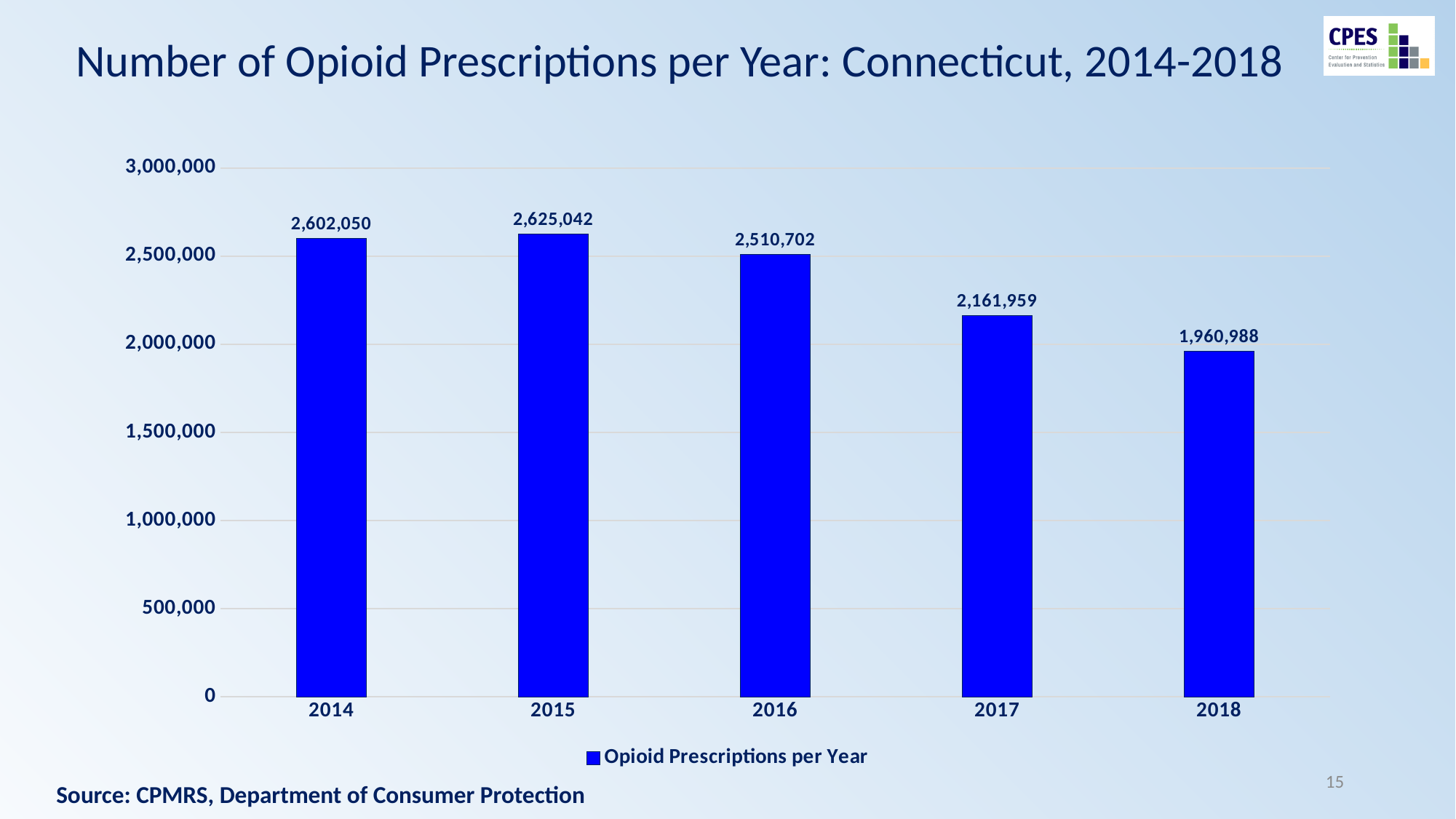
What is the number of opioid prescriptions in 2016? 2,510,702 Which year has the lowest number of opioid prescriptions? 2018 What is the number of opioid prescriptions in 2014? 2,602,050 Do the values rise or fall from 2015 to 2018? Fall How many years are shown on the x axis? 5 What is the difference in opioid prescriptions between 2015 and 2014? 22,992 Which year had more opioid prescriptions, 2016 or 2017? 2016 What is the number of opioid prescriptions in 2018? 1,960,988 Which year has the highest number of opioid prescriptions? 2015 Is the value for 2017 greater or less than 2,000,000? greater What kind of chart is shown on the slide? Bar chart What is the difference in opioid prescriptions between 2017 and 2018? 200,971